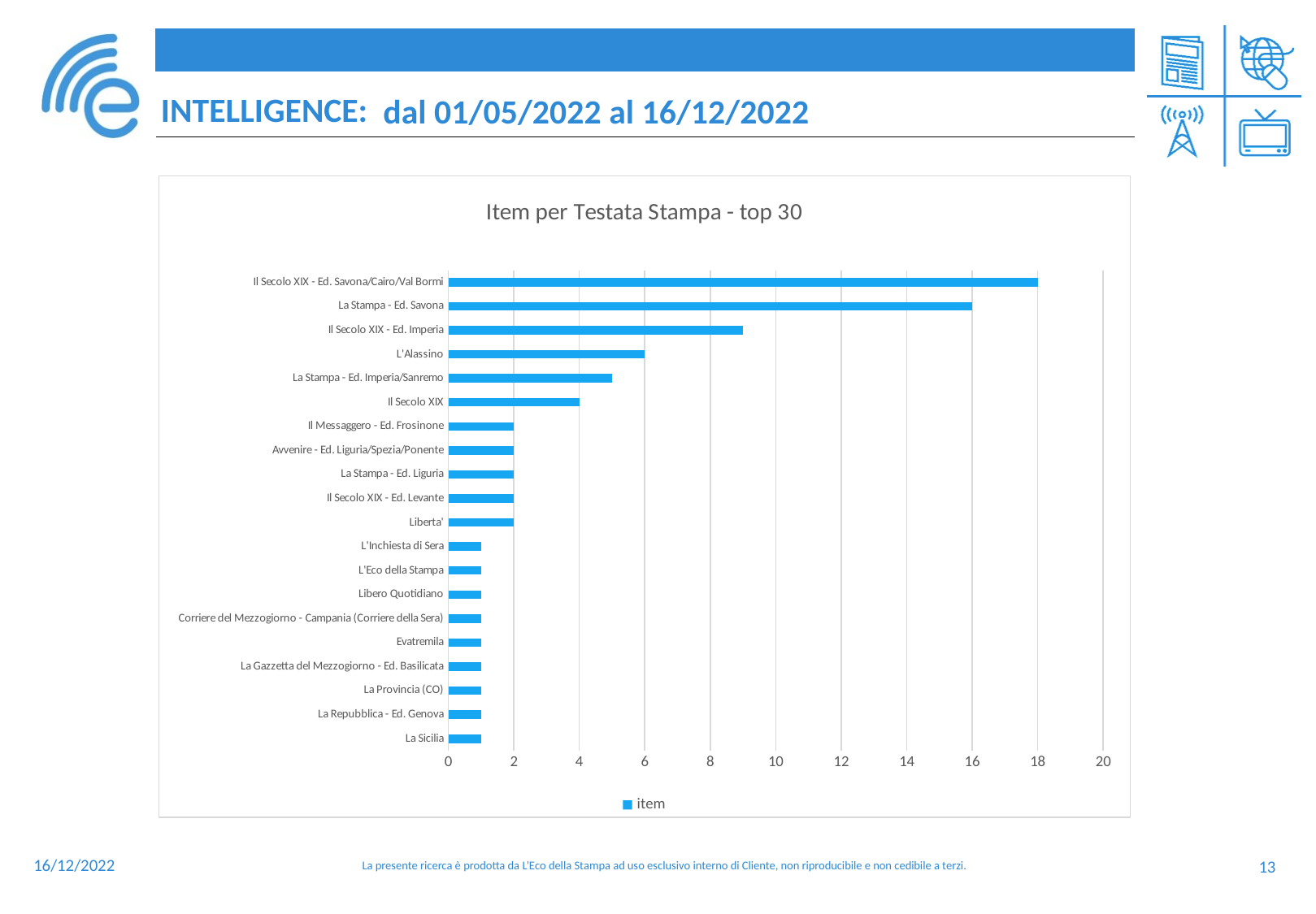
What is the difference between the values for Il Secolo XIX - Ed. Savona/Cairo/Val Bormi and La Stampa - Ed. Savona? 2 What is the value for La Stampa - Ed. Savona? 16 What is the title of the chart? Item per Testata Stampa - top 30 Which is larger, the value for L'Alassino or the value for La Stampa - Ed. Imperia/Sanremo? L'Alassino What is the value for Il Secolo XIX - Ed. Savona/Cairo/Val Bormi? 18 How many series does the legend list? 1 What is the value for L'Alassino? 6 What is the value for Il Secolo XIX? 4 Which testata has the highest number of items? Il Secolo XIX - Ed. Savona/Cairo/Val Bormi How many categories (testate) are plotted in the chart? 20 Is the value for Il Secolo XIX - Ed. Imperia greater or less than 8? greater What kind of chart is shown on the slide? bar chart